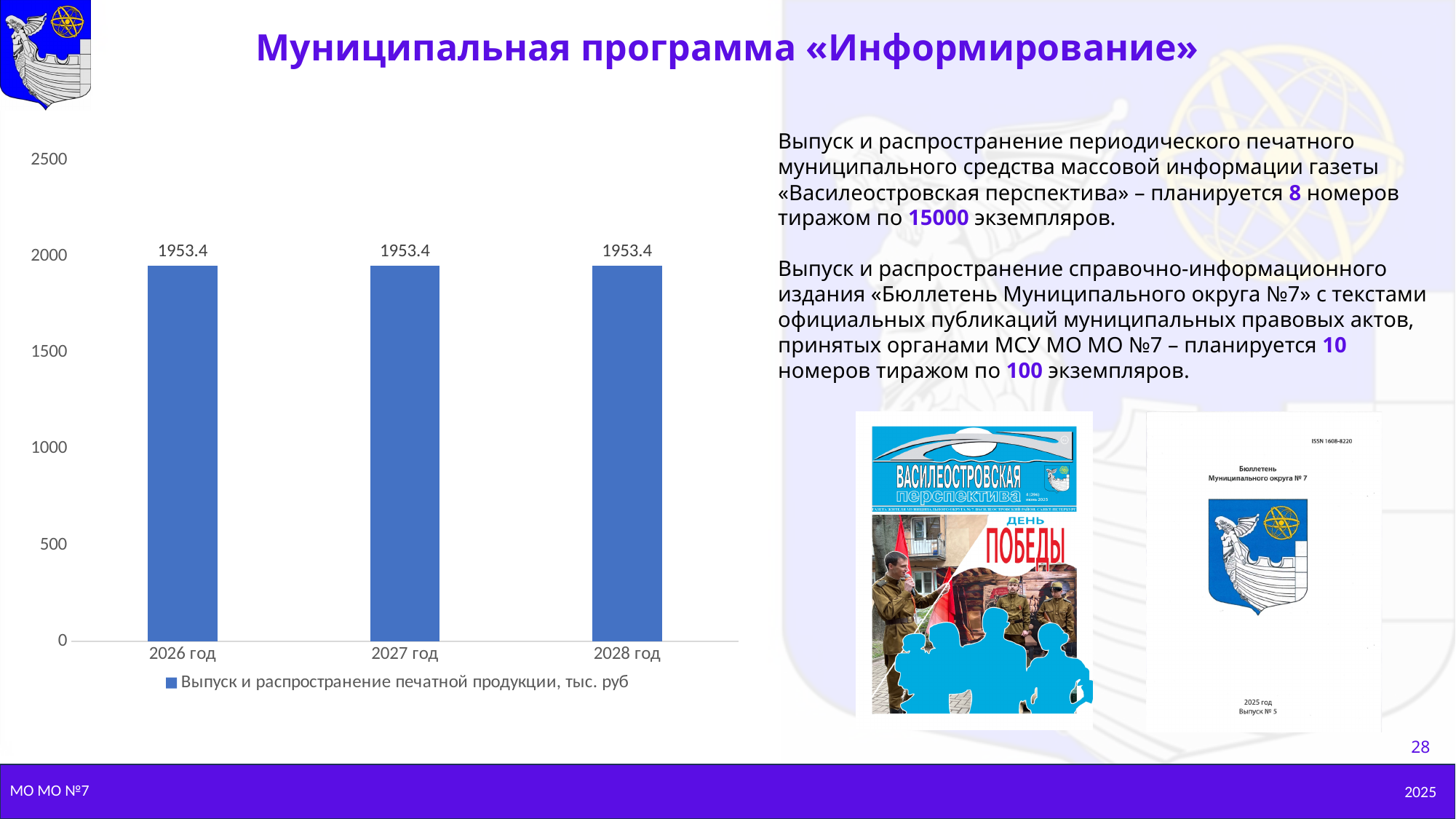
What is the value for 2026 год? 1953.4 How many categories are shown on the x axis? 3 What is the value for 2027 год? 1953.4 What is the value for 2028 год? 1953.4 Do the values rise, fall or stay the same from 2026 год to 2028 год? stay the same Is the value for 2027 год greater or less than 1500? greater What is the legend entry for the series shown in the chart? Выпуск и распространение печатной продукции, тыс. руб What colour are the bars in the chart? blue Is the value for 2026 год greater or less than 2000? less What is the difference between the values for 2026 год and 2028 год? 0 What kind of chart is shown on the slide? bar chart How many series does the legend list? 1